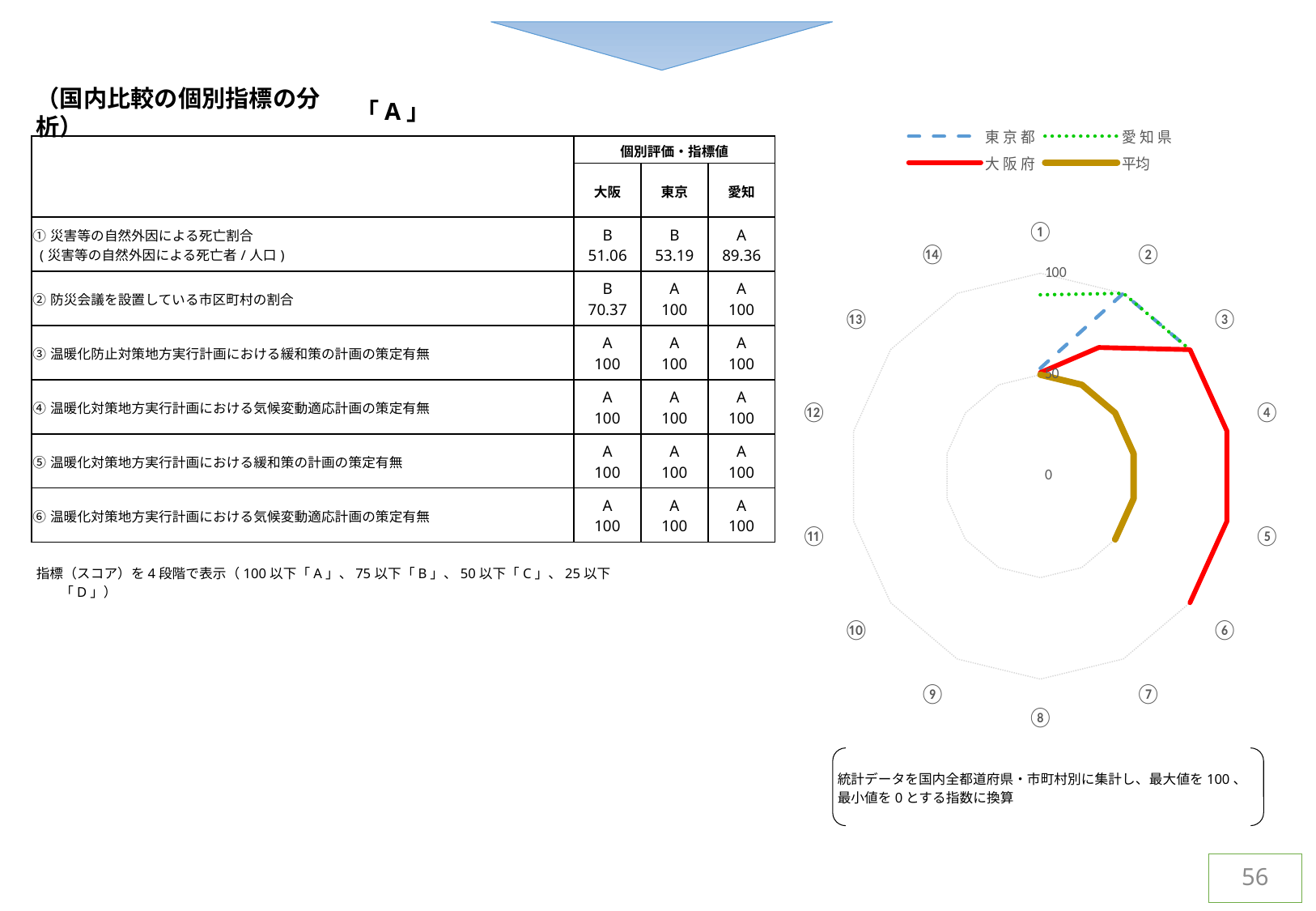
How many numbered categories are arranged around the radar chart? 14 Which series in the radar chart is drawn as a solid red line? 大阪府 What kind of chart is shown on the right side of the slide? radar chart In the radar chart, which is larger at category ③: the value for 大阪府 or the value for 平均? 大阪府 Which series in the radar chart is drawn as a blue dashed line? 東京都 In the radar chart, which is larger at category ⑤: the value for 大阪府 or the value for 平均? 大阪府 Is the value for 大阪府 at category ⑤ in the radar chart greater or less than 50? greater Is the value for 東京都 at category ② in the radar chart greater or less than 50? greater What is the maximum value shown on the radar chart's axis? 100 Is the value for 愛知県 at category ③ in the radar chart greater or less than 50? greater How many series does the legend of the radar chart list? 4